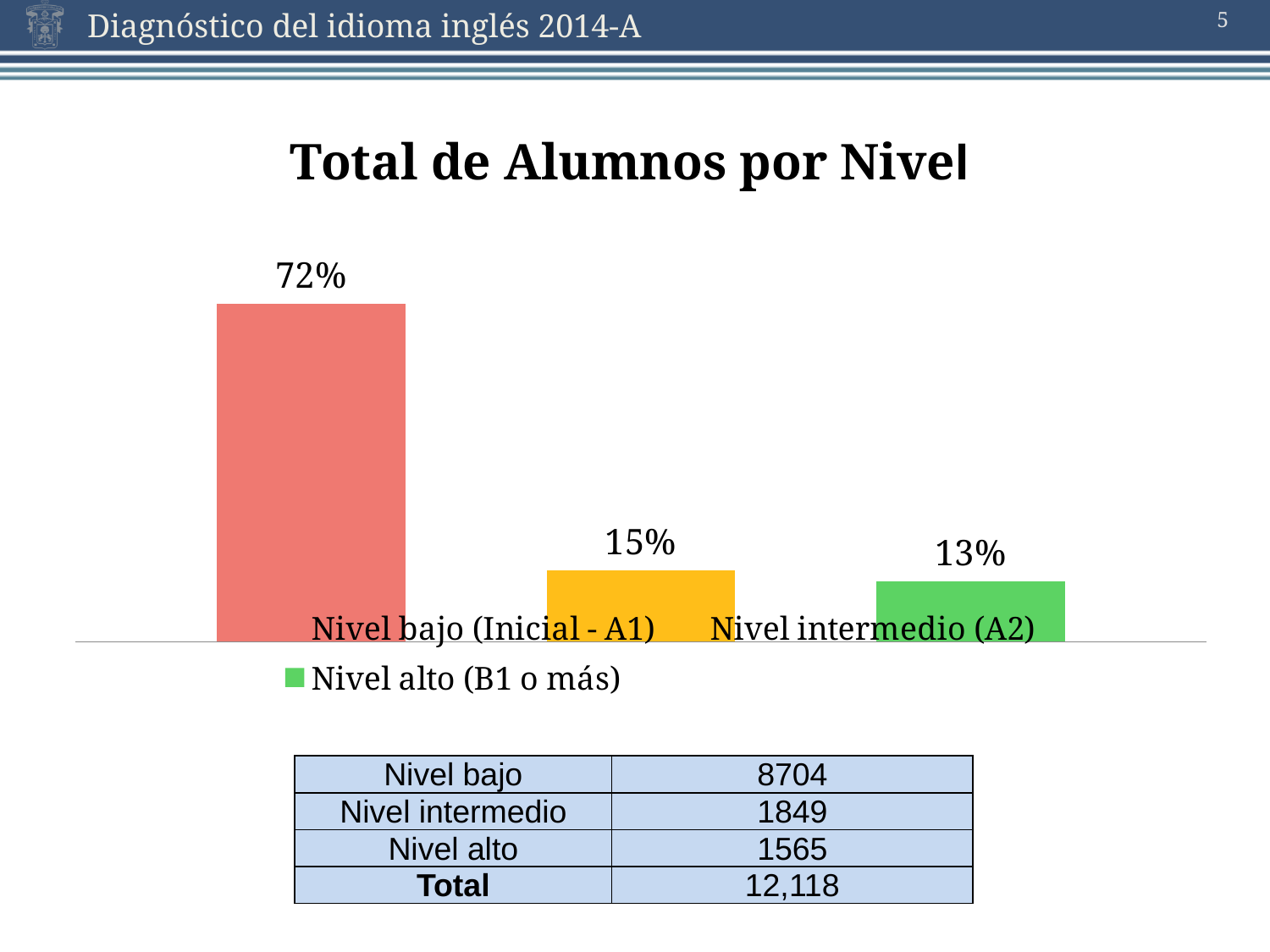
What is the difference in percentage points between Nivel bajo (Inicial - A1) and Nivel intermedio (A2)? 57 What is the title of the chart? Total de Alumnos por Nivel How many bars are plotted in the chart? 3 What is the difference in percentage points between Nivel intermedio (A2) and Nivel alto (B1 o más)? 2 What kind of chart is shown on the slide? Bar chart How many entries does the chart legend list? 3 Which level has the lowest percentage of students? Nivel alto (B1 o más) Which is larger, the percentage for Nivel intermedio (A2) or for Nivel alto (B1 o más)? Nivel intermedio (A2) What percentage is shown for Nivel alto (B1 o más)? 13% What percentage is shown for Nivel bajo (Inicial - A1)? 72% Which level has the highest percentage of students? Nivel bajo (Inicial - A1) What percentage is shown for Nivel intermedio (A2)? 15%